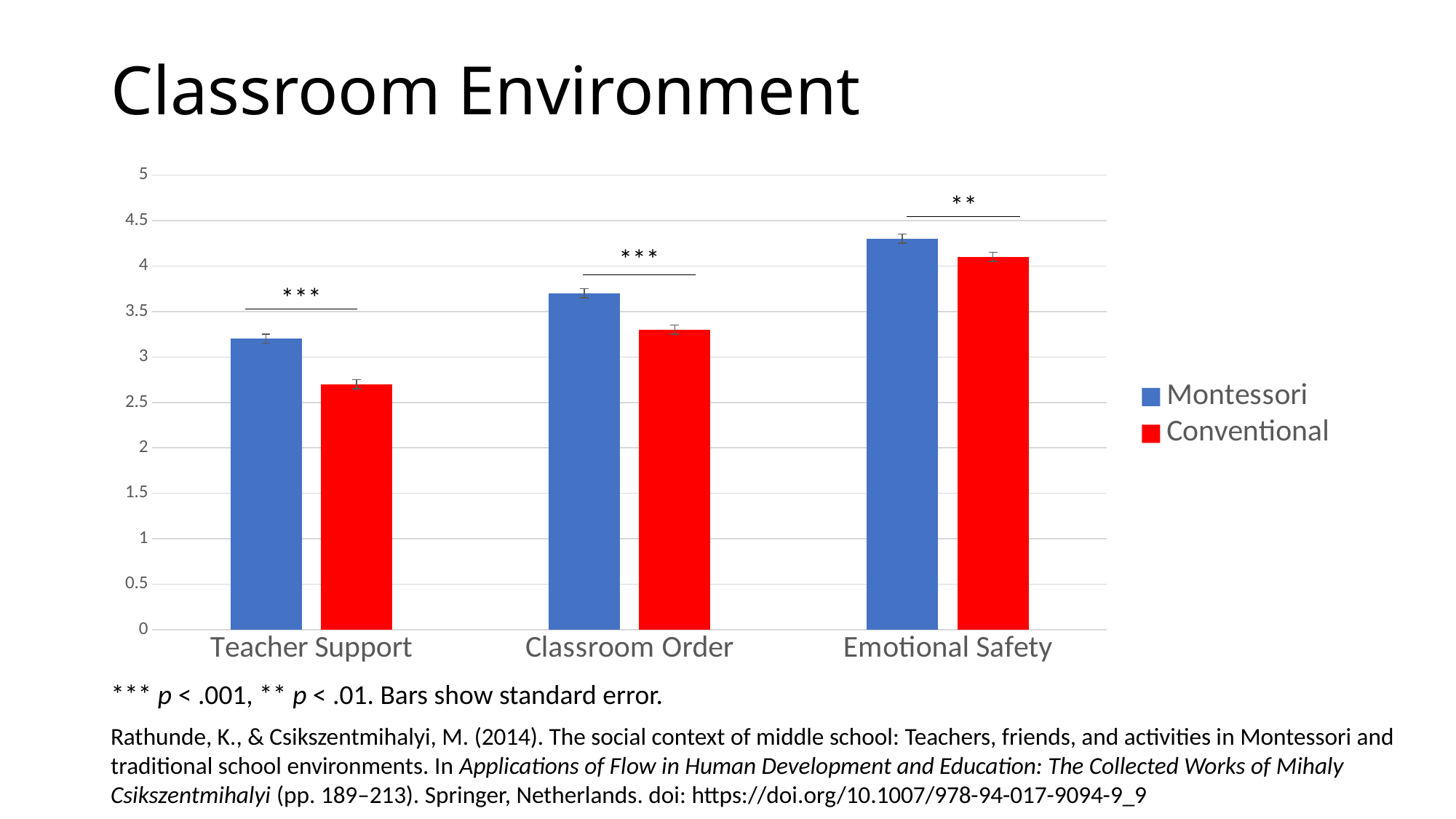
For Teacher Support, which is larger: the Montessori value or the Conventional value? Montessori Is the Montessori value for Classroom Order greater or less than 3.5? greater Is the Conventional value for Teacher Support greater or less than 3? less What kind of chart is shown on the slide? bar chart How many series does the chart's legend list? 2 Which category has the highest Montessori value? Emotional Safety Which category has the lowest Conventional value? Teacher Support Is the Conventional value for Emotional Safety greater or less than 4.5? less How many categories are shown on the x axis of the chart? 3 For Classroom Order, which is larger: the Montessori value or the Conventional value? Montessori Which colour represents the Conventional series in the chart? red